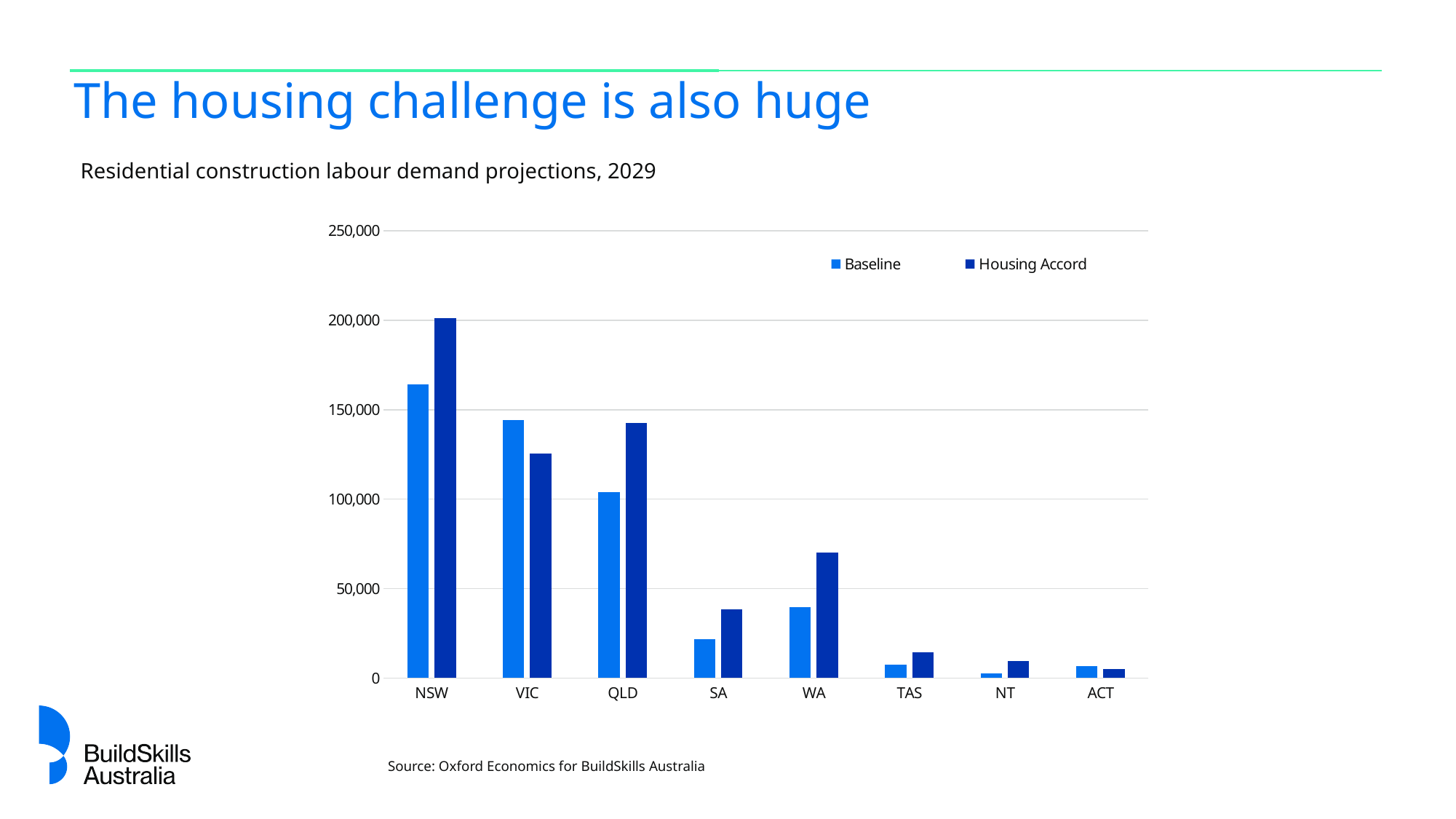
Is the Housing Accord value for WA greater or less than 50,000? greater How many states and territories are shown on the x axis? 8 What kind of chart is shown on the slide? Bar chart What is the subtitle describing the chart's data? Residential construction labour demand projections, 2029 Which state or territory has the lowest Baseline value? NT How many series does the legend list? 2 Is the Baseline value for SA greater or less than 50,000? less Is the Baseline value for NSW greater or less than 150,000? greater Which state has the highest Baseline value? NSW Which state or territory has the highest Housing Accord value? NSW For VIC, which is larger: the Baseline value or the Housing Accord value? Baseline For QLD, which is larger: the Baseline value or the Housing Accord value? Housing Accord